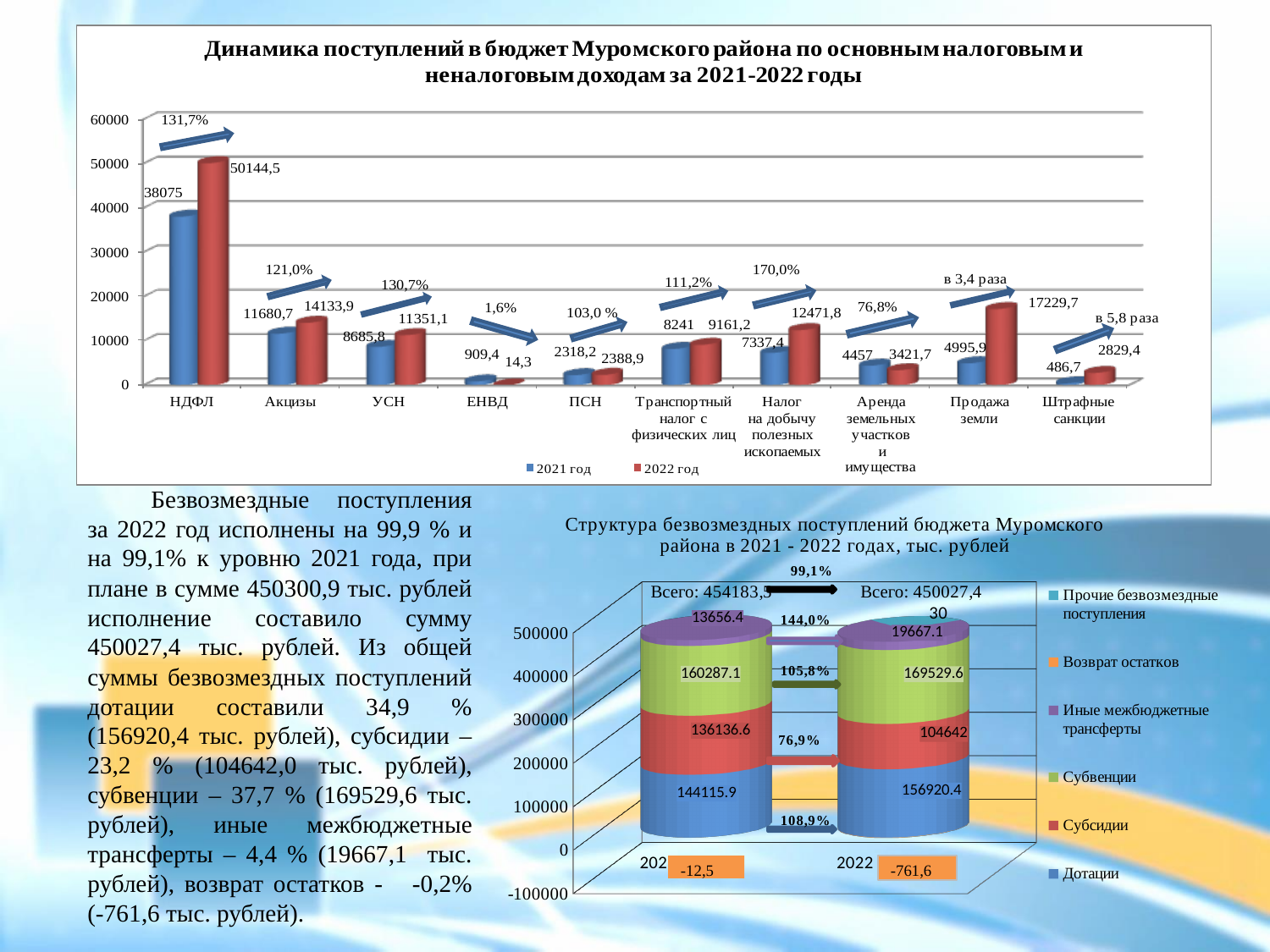
What type of chart is the bottom chart 'Структура безвозмездных поступлений'? Stacked bar chart In the top chart 'Динамика поступлений в бюджет Муромского района', which category has the highest 2022 год value? НДФЛ In the bottom chart 'Структура безвозмездных поступлений', what is the value of Субсидии for 2022? 104642 In the top chart 'Динамика поступлений в бюджет Муромского района', what is the 2021 год value for Акцизы? 11680,7 In the bottom chart 'Структура безвозмездных поступлений', how many series does the legend list? 6 In the top chart 'Динамика поступлений в бюджет Муромского района', which category has the lowest 2022 год value? ЕНВД In the top chart 'Динамика поступлений в бюджет Муромского района', what percentage label is shown above the bars for Налог на добычу полезных ископаемых? 170,0% In the bottom chart 'Структура безвозмездных поступлений', what is the total for 2021 shown above the stacked bar? 454183,5 In the top chart 'Динамика поступлений в бюджет Муромского района', which is larger for Аренда земельных участков и имущества: the 2021 год value or the 2022 год value? 2021 год In the top chart 'Динамика поступлений в бюджет Муромского района', what is the 2022 год value for НДФЛ? 50144,5 In the top chart 'Динамика поступлений в бюджет Муромского района', how many categories are shown on the x axis? 10 In the top chart 'Динамика поступлений в бюджет Муромского района', what is the difference between the 2022 год and 2021 год values for НДФЛ? 12069,5